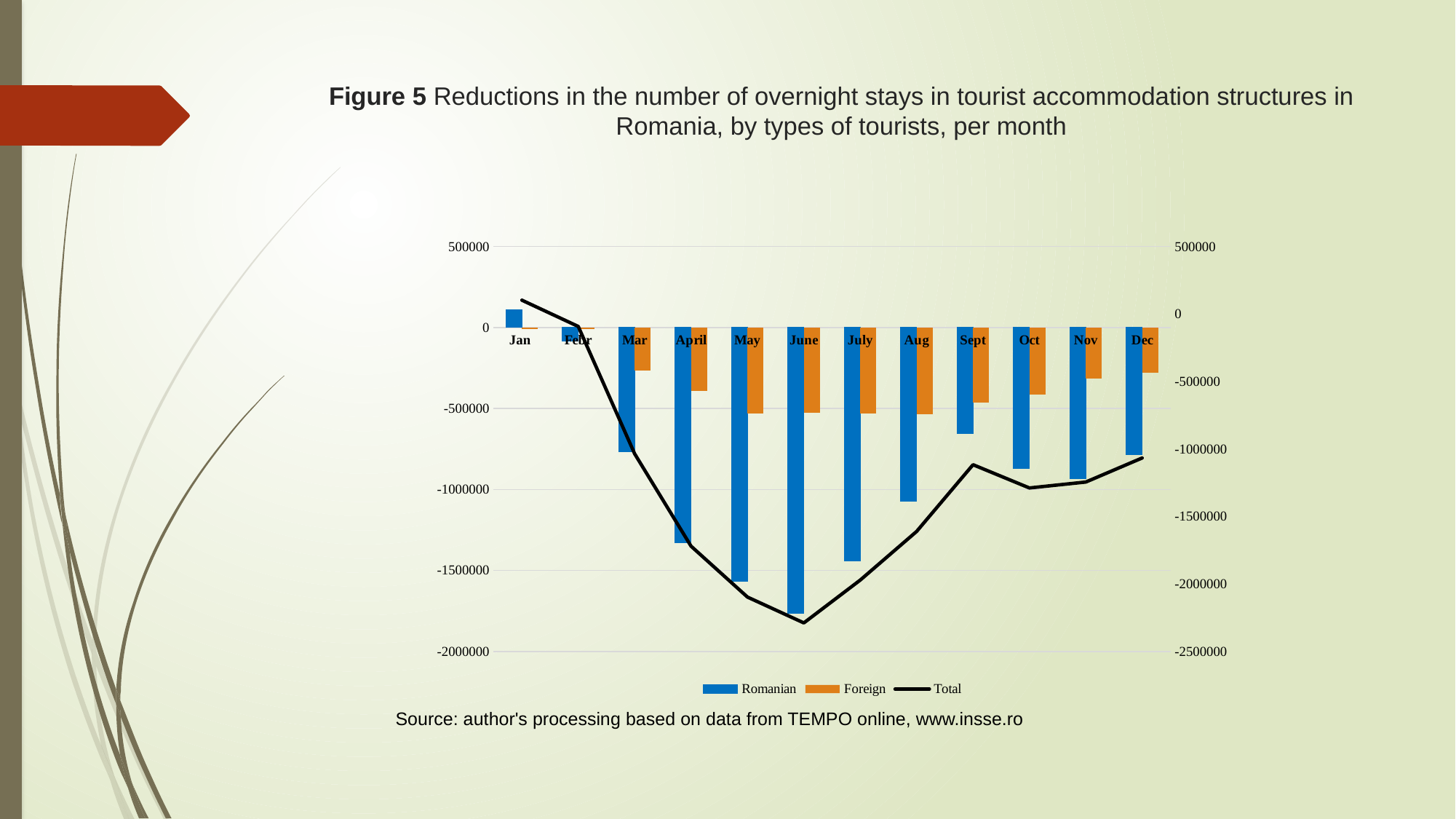
Which is lower, the Romanian value for July or the Romanian value for Aug? July How many months are shown on the x axis of the chart? 12 Is the Romanian value for Sept greater or less than -1000000? greater What kind of chart is shown on the slide? A combined bar and line chart Which month is the only one where the Romanian bar is positive? Jan Is the Foreign value for Mar greater or less than -500000? greater Which series are listed in the chart legend? Romanian, Foreign, Total Is the Romanian value for June greater or less than -1500000? less In which month does the Romanian series reach its lowest value? June Does the Total line rise or fall from Jan to June? Fall How many series does the chart legend list? 3 In which month does the Total line reach its lowest point? June